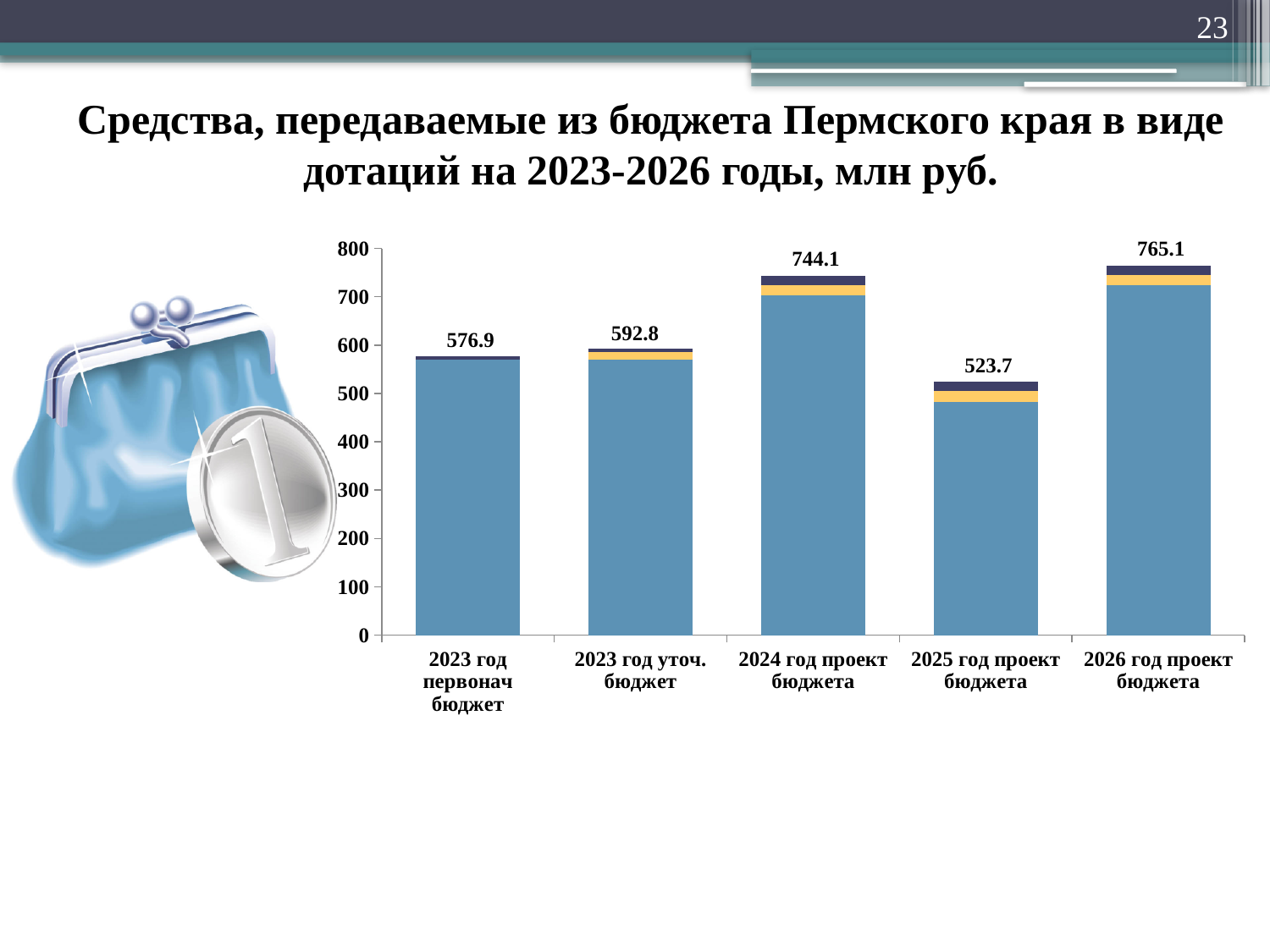
What kind of chart is shown on the slide? bar chart What is the total value shown for the bar labelled "2024 год проект бюджета"? 744.1 Is the total for "2025 год проект бюджета" greater or less than 500? greater Which category has the highest total value? 2026 год проект бюджета Does the total value rise or fall from "2024 год проект бюджета" to "2025 год проект бюджета"? fall What is the difference between the totals for "2026 год проект бюджета" and "2025 год проект бюджета"? 241.4 Which is larger: the total for "2024 год проект бюджета" or the total for "2026 год проект бюджета"? 2026 год проект бюджета What is the total value shown for the bar labelled "2025 год проект бюджета"? 523.7 How many bars (categories) are shown on the chart? 5 Which category has the lowest total value? 2025 год проект бюджета What is the difference between the totals for "2023 год уточ. бюджет" and "2023 год первонач бюджет"? 15.9 What is the total value shown for the bar labelled "2023 год первонач бюджет"? 576.9